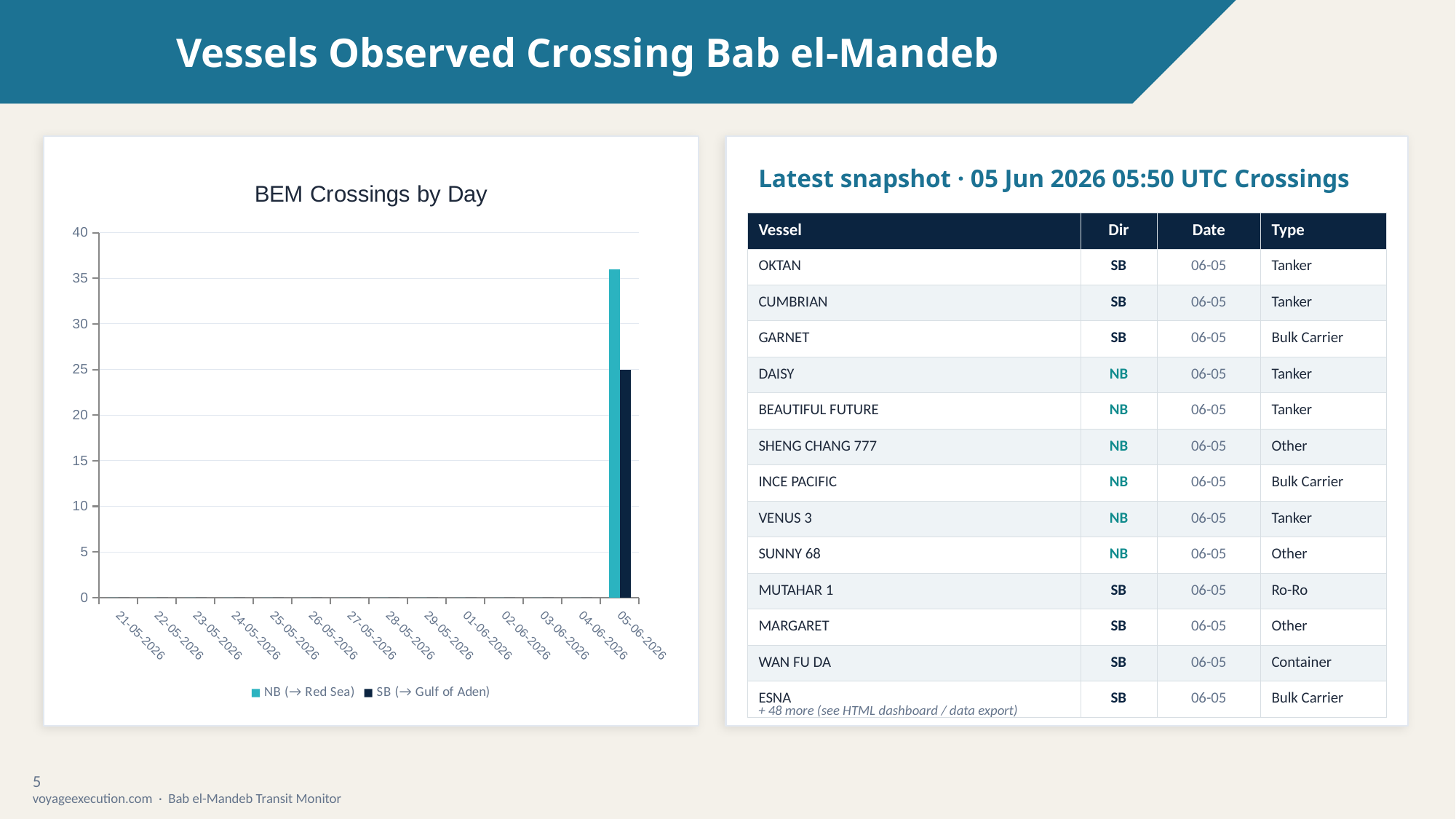
In "BEM Crossings by Day", is the SB (→ Gulf of Aden) value on 05-06-2026 greater or less than 20? greater On which date does the SB (→ Gulf of Aden) series reach its highest value in "BEM Crossings by Day"? 05-06-2026 In "BEM Crossings by Day", is the NB (→ Red Sea) value on 05-06-2026 greater or less than 35? greater What are the two series named in the legend of "BEM Crossings by Day"? NB (→ Red Sea) and SB (→ Gulf of Aden) How many dates are shown on the x axis of "BEM Crossings by Day"? 14 In "BEM Crossings by Day", which series has the larger value on 05-06-2026, NB (→ Red Sea) or SB (→ Gulf of Aden)? NB (→ Red Sea) How many series does the legend of "BEM Crossings by Day" list? 2 In "BEM Crossings by Day", is the SB (→ Gulf of Aden) value on 05-06-2026 greater or less than 30? less What is the title of the chart on the left of the slide? BEM Crossings by Day What kind of chart is "BEM Crossings by Day"? bar chart What is the SB (→ Gulf of Aden) value on 05-06-2026 in "BEM Crossings by Day"? 25 On which date does the NB (→ Red Sea) series reach its highest value in "BEM Crossings by Day"? 05-06-2026